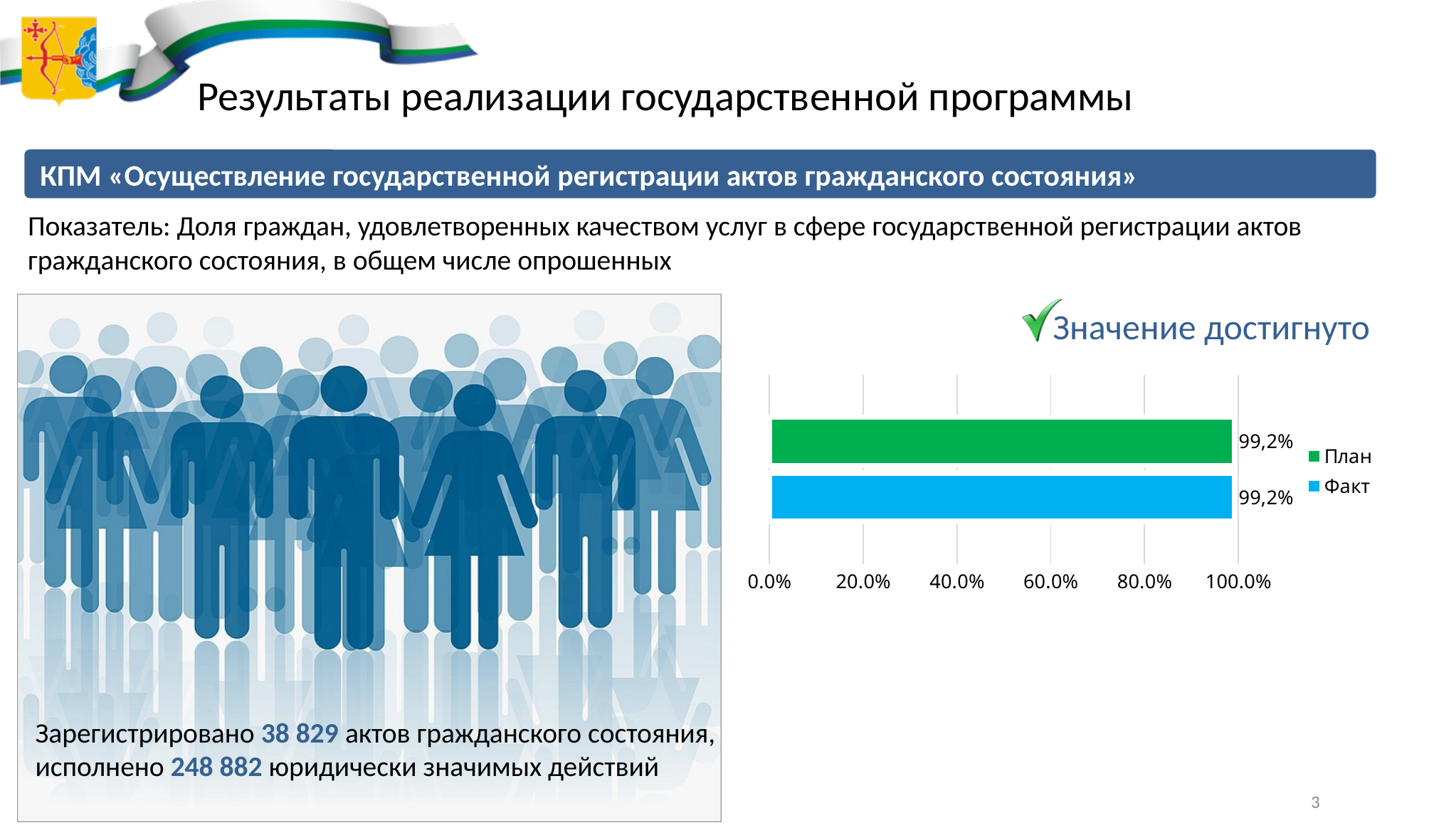
What kind of chart is shown on the slide? bar chart Is the value for Факт greater or less than 80.0%? greater What is the difference between the План and Факт values? 0,0% How many bars are plotted in the chart? 2 Which series is shown in green? План What is the value of the План bar? 99,2% What is the value of the Факт bar? 99,2% What is the highest tick label on the horizontal axis? 100.0% Which series is shown in light blue? Факт Is the value for План greater or less than 100.0%? less How many series does the legend list? 2